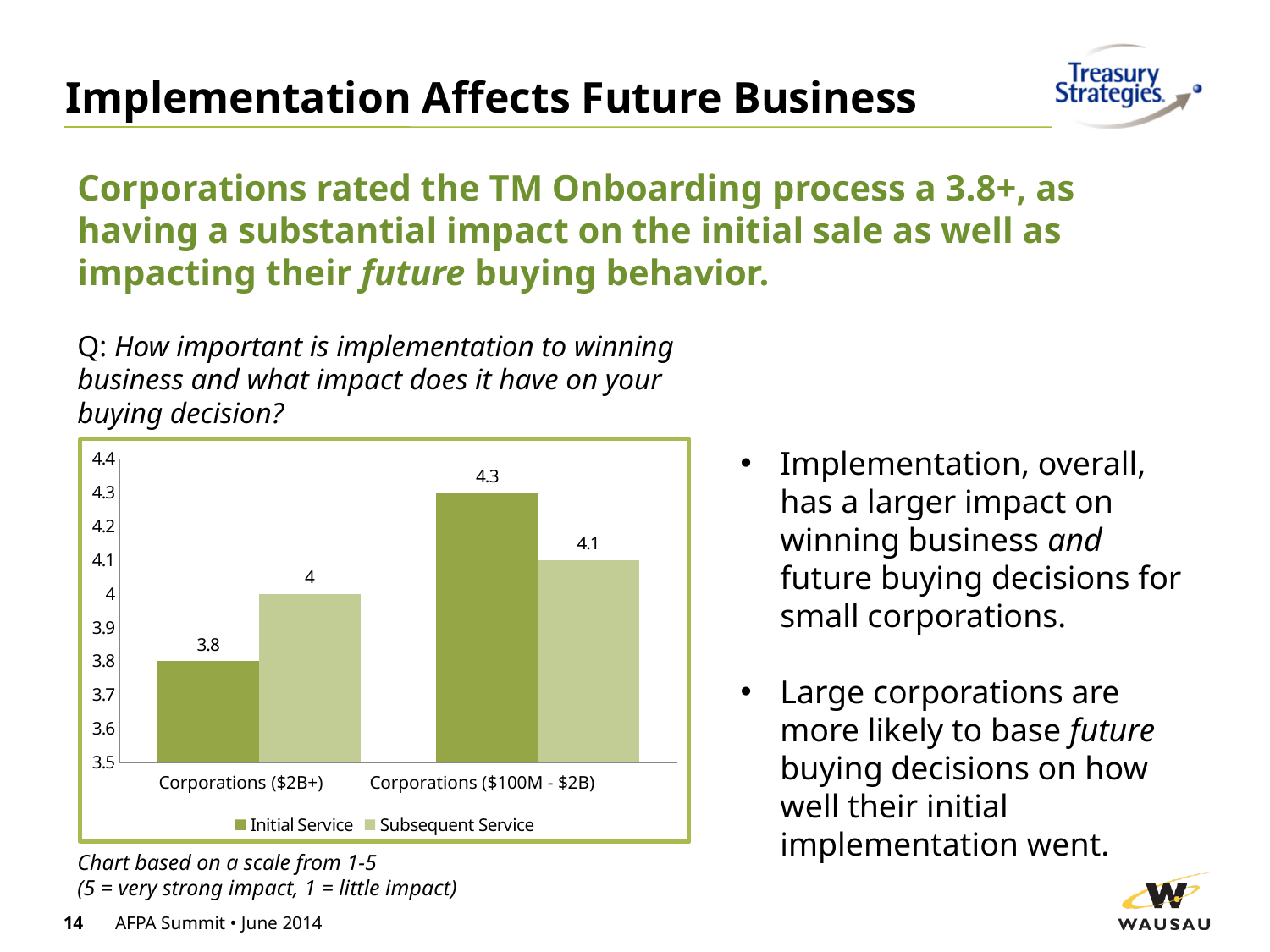
What are the two series named in the legend? Initial Service and Subsequent Service For Corporations ($2B+), which is larger: Initial Service or Subsequent Service? Subsequent Service What is the Subsequent Service value for Corporations ($2B+)? 4 What kind of chart is shown on the slide? Bar chart How many series does the legend list? 2 Which category has the highest Initial Service value? Corporations ($100M - $2B) What is the Initial Service value for Corporations ($100M - $2B)? 4.3 What is the Initial Service value for Corporations ($2B+)? 3.8 Which category has the lowest Subsequent Service value? Corporations ($2B+) How many categories are shown on the x axis? 2 What is the Subsequent Service value for Corporations ($100M - $2B)? 4.1 What is the difference between the Initial Service values for Corporations ($100M - $2B) and Corporations ($2B+)? 0.5